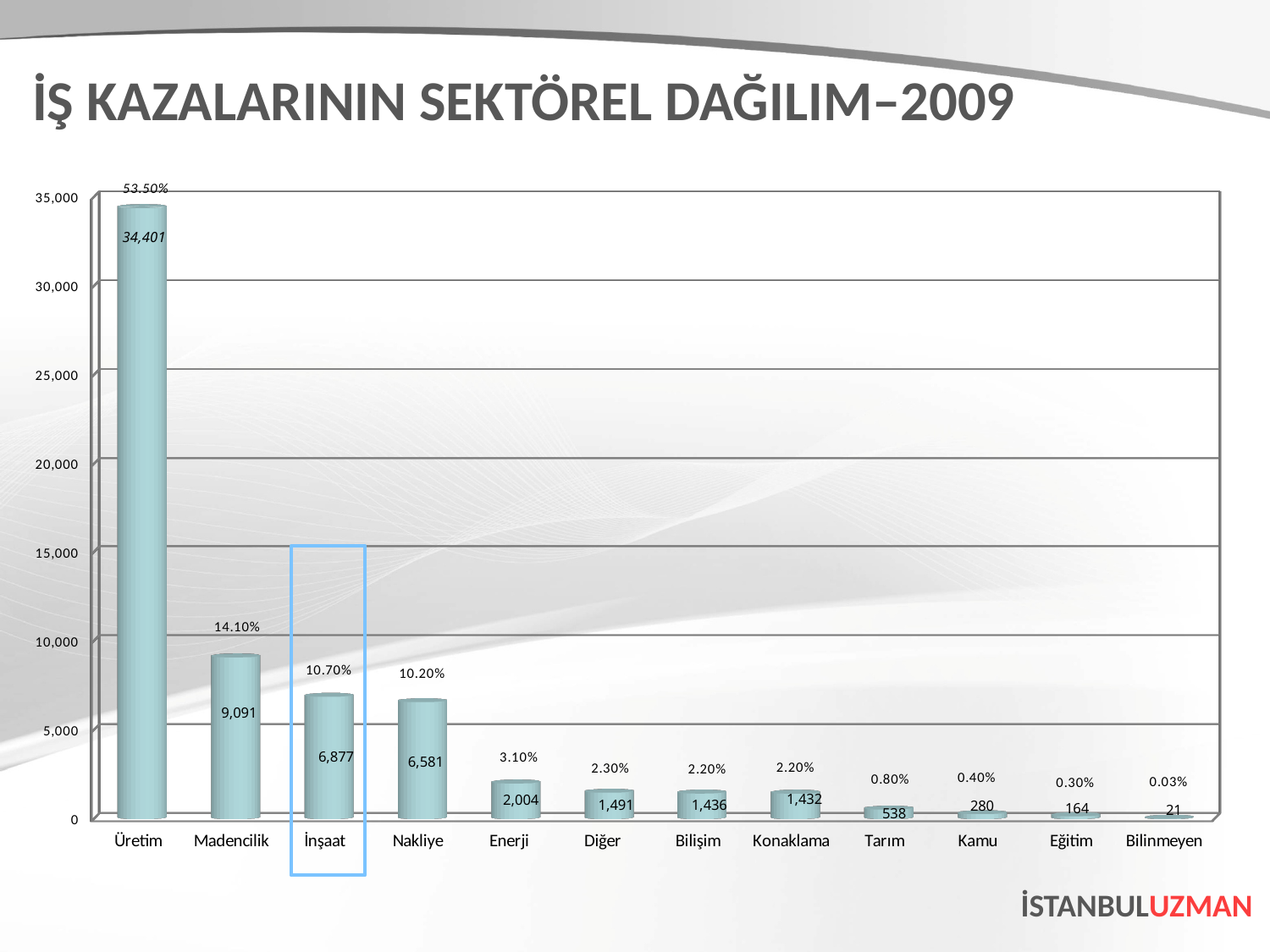
What is the value for İnşaat? 6,877 What is the title of the slide? İŞ KAZALARININ SEKTÖREL DAĞILIM–2009 What is the difference between the values for Madencilik and Nakliye? 2,510 Which is larger, the value for Enerji or the value for Diğer? Enerji What is the value for Bilinmeyen? 21 What kind of chart is shown on the slide? bar chart Which category has the lowest value? Bilinmeyen How many categories are shown on the x axis? 12 Which category has the highest value? Üretim What percentage label is shown above the Madencilik bar? 14.10% What is the value for Üretim? 34,401 Is the value for Üretim greater or less than 30,000? greater